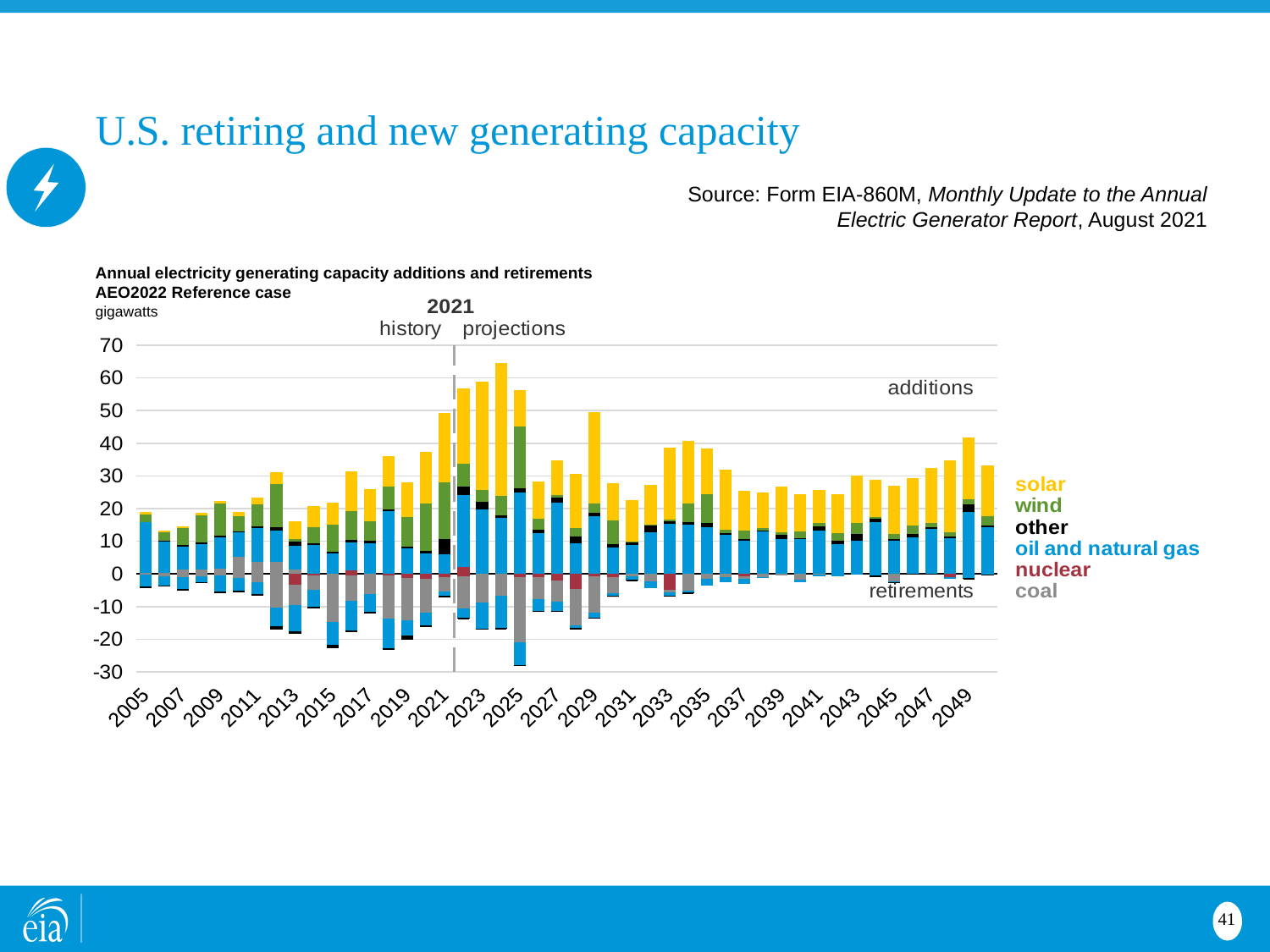
Is the total additions value for 2037 greater or less than 30? less How many series does the legend list? 6 Which year has larger total additions, 2022 or 2013? 2022 Do total additions generally rise or fall from 2037 to 2049? rise What unit is the y axis measured in? gigawatts Which year separates history from projections on the chart? 2021 Is the total additions value for 2013 greater or less than 20? less In which year is the additions bar (above zero) the tallest? 2024 In which year does the retirements bar (below zero) extend the furthest down? 2025 Is the total additions value for 2025 greater or less than 60? less What kind of chart is shown on the slide? bar chart